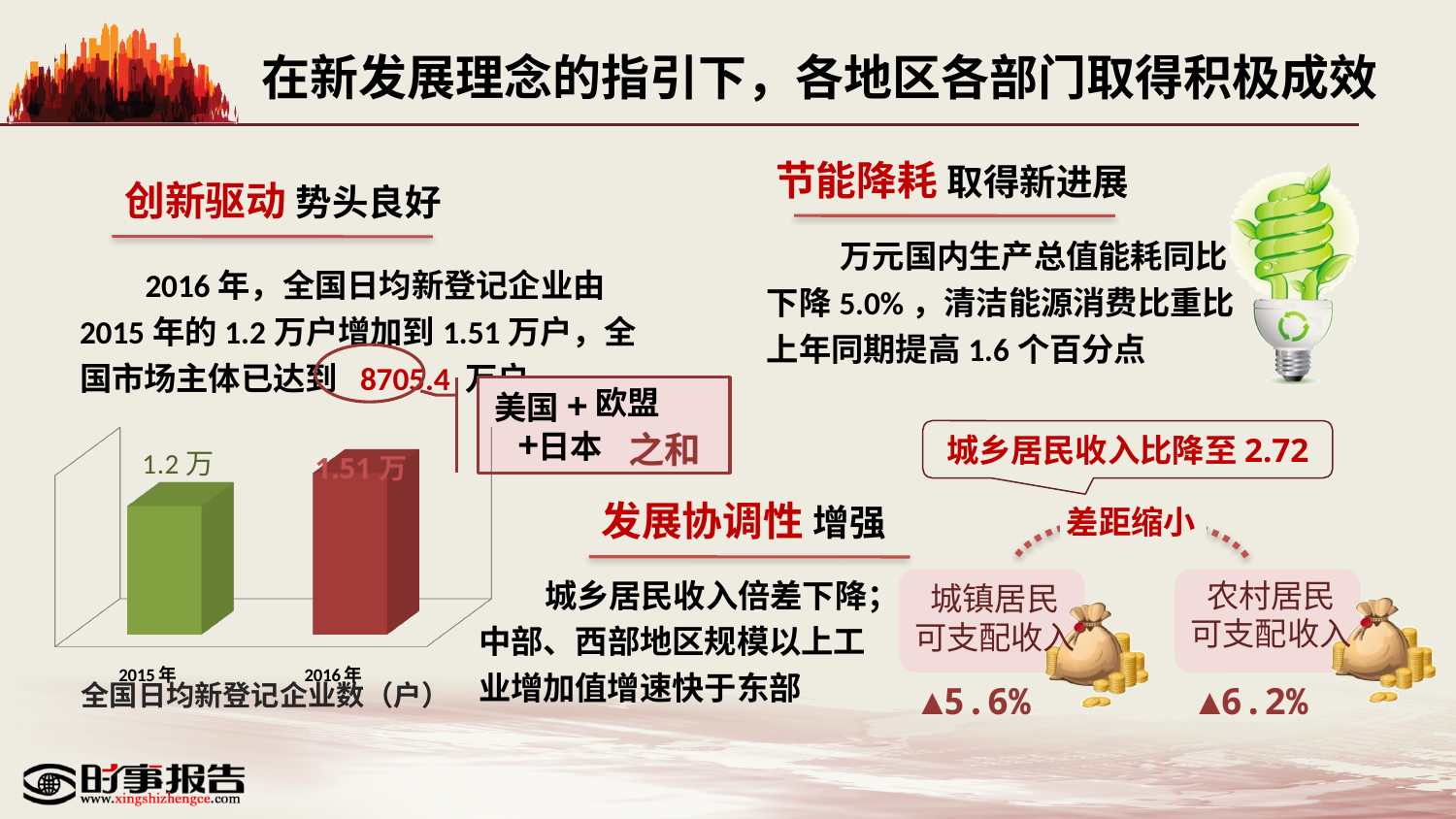
Is the value for 2016年 larger or smaller than the value for 2015年 in the chart 全国日均新登记企业数（户）? larger Do the values in the chart 全国日均新登记企业数（户） rise or fall from 2015年 to 2016年? rise By how much does the 2016年 value exceed the 2015年 value in the chart 全国日均新登记企业数（户）? 0.31 万 What colour is the 2016年 bar in the chart 全国日均新登记企业数（户）? red What is the title of the bar chart on the slide? 全国日均新登记企业数（户） What kind of chart is 全国日均新登记企业数（户）? bar chart Which year has the lower bar in the chart 全国日均新登记企业数（户）? 2015年 Which year has the higher bar in the chart 全国日均新登记企业数（户）? 2016年 What is the value shown for 2016年 in the chart 全国日均新登记企业数（户）? 1.51 万 How many bars are plotted in the chart 全国日均新登记企业数（户）? 2 What is the value shown for 2015年 in the chart 全国日均新登记企业数（户）? 1.2 万